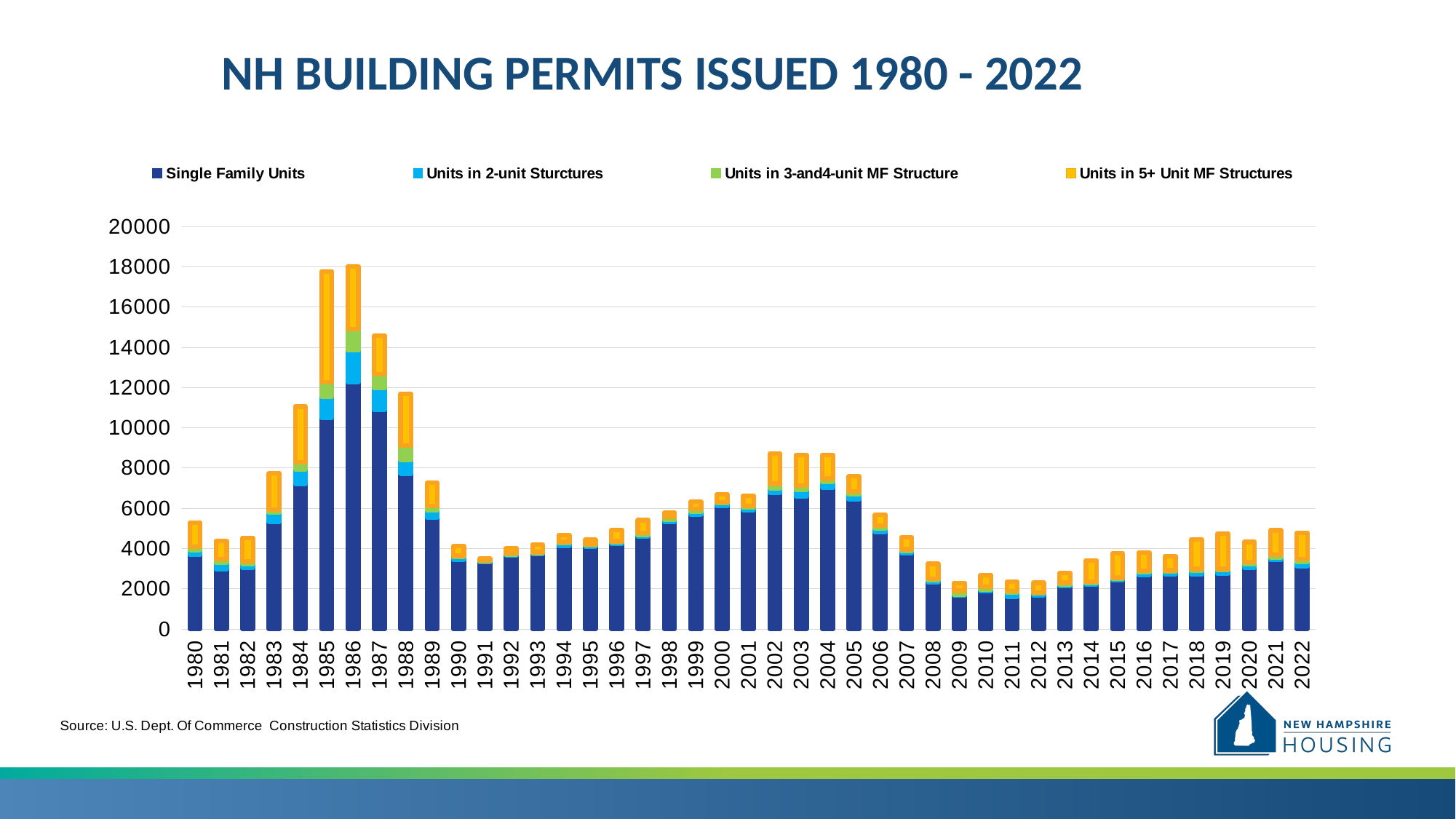
Is the total value for 1986 greater or less than 16000? greater Which year has a larger total bar, 1985 or 1990? 1985 Do the total bar heights rise or fall from 1983 to 1986? rise What is the title of the chart? NH BUILDING PERMITS ISSUED 1980 - 2022 How many years are shown along the x axis? 43 Is the total value for 2002 greater or less than 8000? greater How many series does the legend list? 4 Is the total value for 2011 greater or less than 4000? less What kind of chart is shown on the slide? Stacked bar chart Which year has a larger total bar, 2002 or 2012? 2002 Do the total bar heights rise or fall from 2005 to 2009? fall